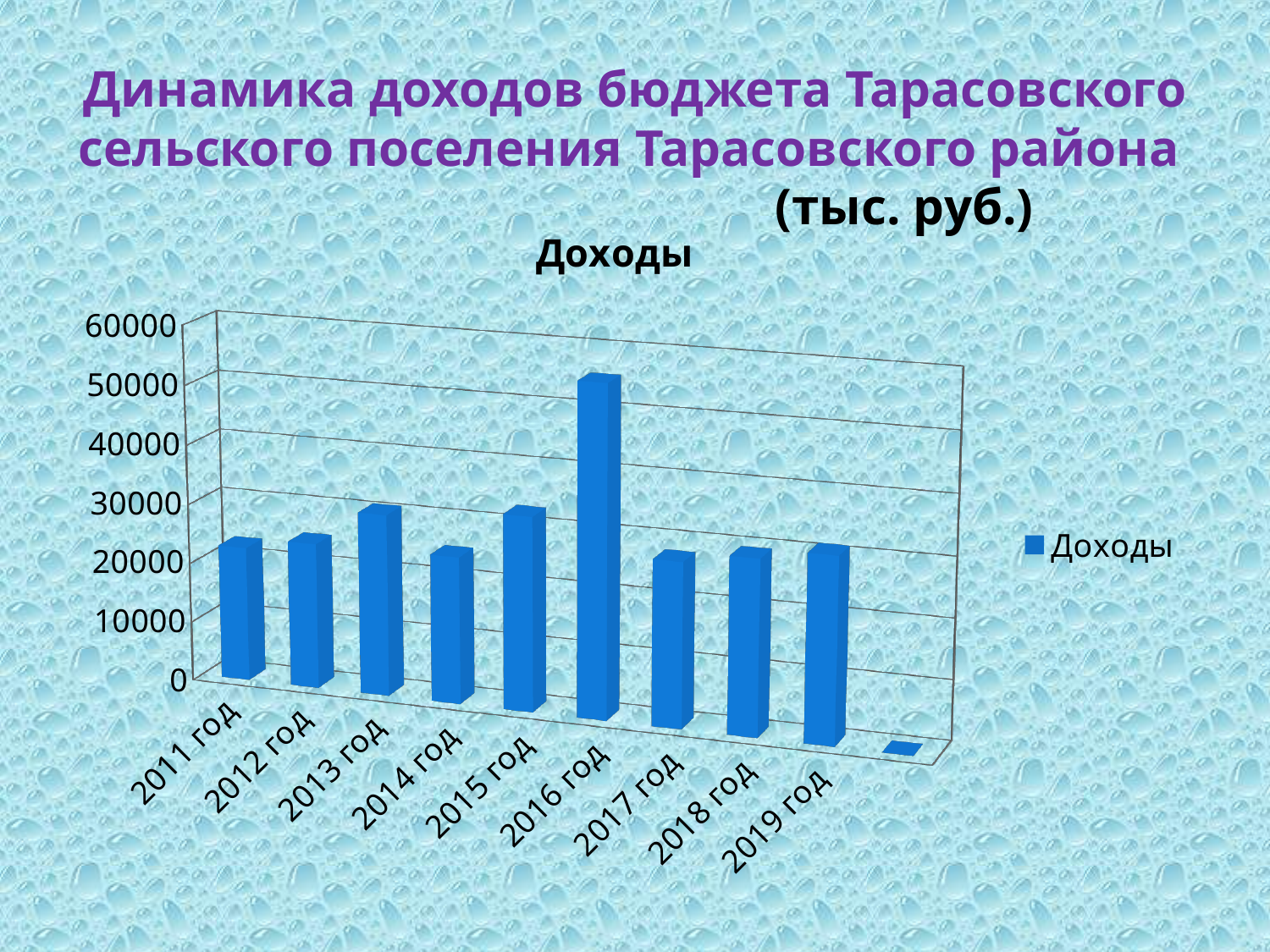
What unit is stated for the values in the slide heading? тыс. руб. What kind of chart is shown on the slide? bar chart Is the value for 2017 год greater or less than 30000? less What is the title of the chart? Доходы Is the value for 2014 год greater or less than 30000? less Is the value for 2016 год greater or less than 40000? greater How many series does the legend list? 1 Which is larger, the value for 2015 год or the value for 2017 год? 2015 год Which is larger, the value for 2013 год or the value for 2014 год? 2013 год Which is larger, the value for 2016 год or the value for 2011 год? 2016 год Which year has the highest income value? 2016 год